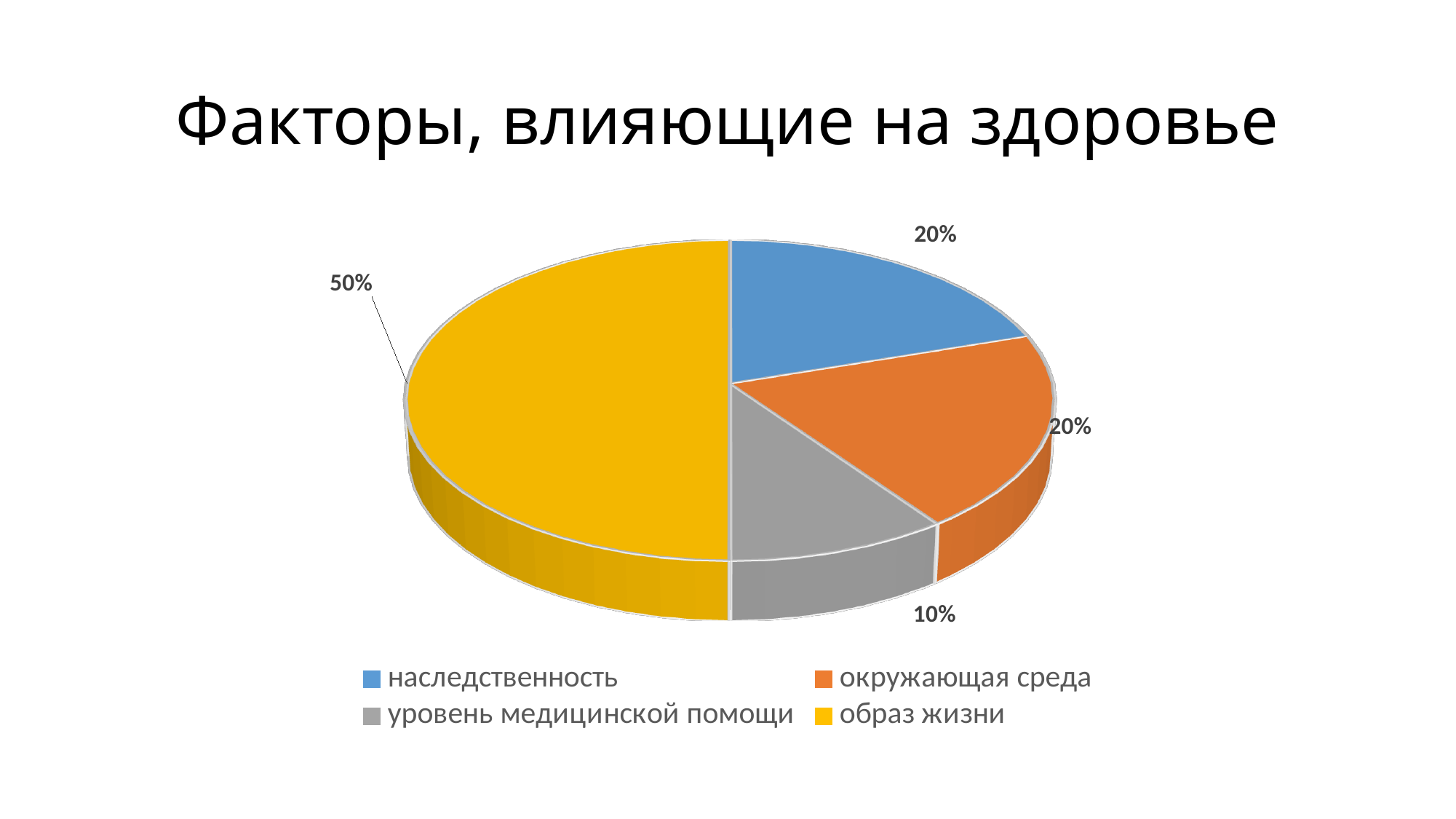
What is the value shown for уровень медицинской помощи? 10% What kind of chart is shown on the slide? pie chart What is the value shown for наследственность? 20% What is the value shown for окружающая среда? 20% Which category has the smallest slice of the pie? уровень медицинской помощи What is the title of the chart? Факторы, влияющие на здоровье Which is larger, the slice for наследственность or the slice for уровень медицинской помощи? наследственность How many categories does the pie chart show? 4 Which colour represents образ жизни in the legend? yellow What share of the pie does образ жизни take? 50% What is the difference between the values for образ жизни and уровень медицинской помощи? 40% Which category has the largest slice of the pie? образ жизни